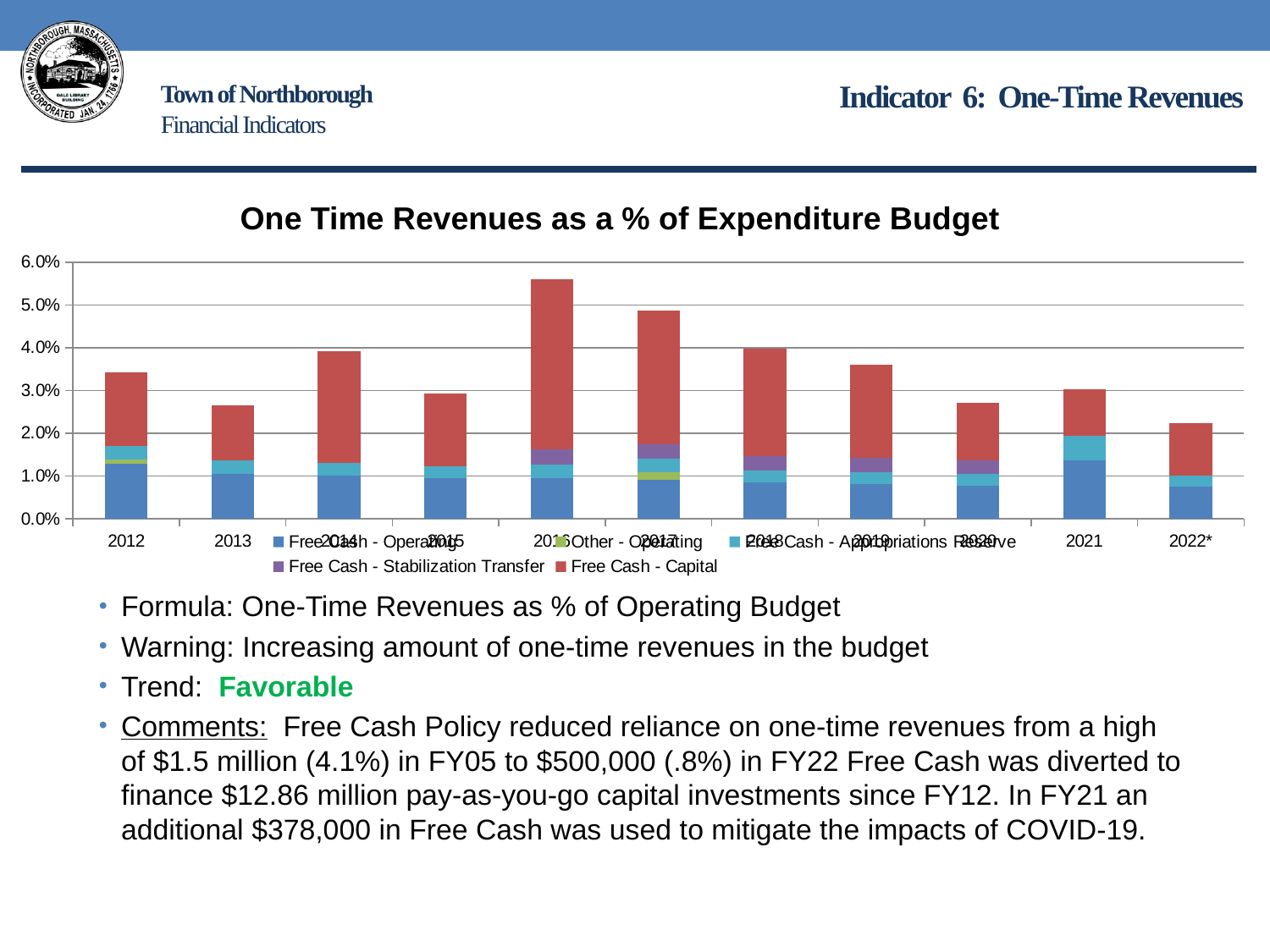
Which year has the lowest total one-time revenues as a % of expenditure budget? 2022* Is the total value for 2012 greater or less than 3.0%? greater Is the total value for 2013 greater or less than 3.0%? less What type of chart is shown on the slide? Stacked bar chart How many series does the chart legend list? 5 Is the total value for 2020 greater or less than 3.0%? less How many years (categories) are shown on the x axis of the chart? 11 Do the total bar values rise or fall from 2016 to 2022*? fall Which year has the highest total one-time revenues as a % of expenditure budget? 2016 Which year has a larger total bar, 2016 or 2017? 2016 What is the title of the chart? One Time Revenues as a % of Expenditure Budget